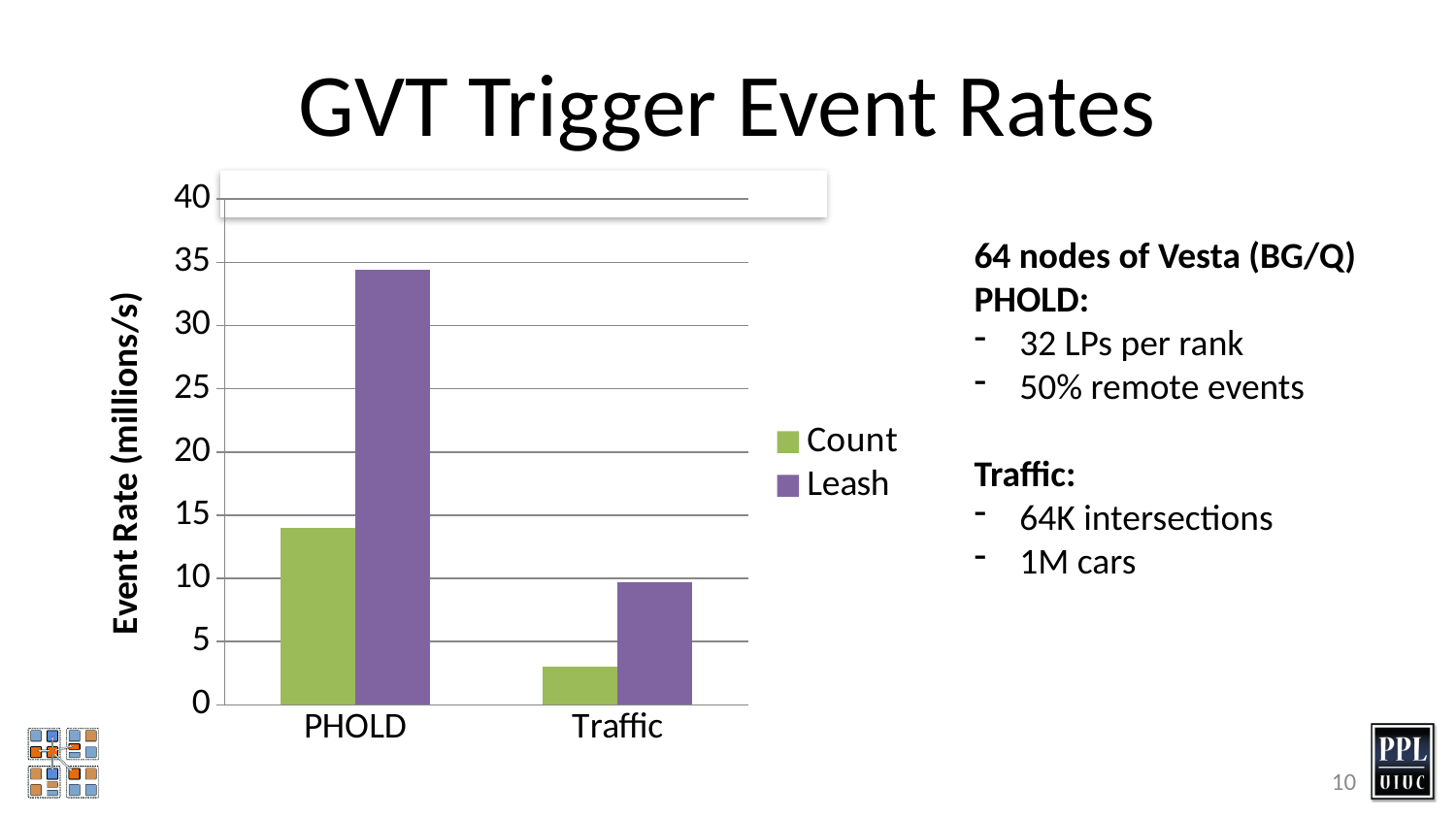
Which series and category has the highest event rate? Leash for PHOLD What is the label of the y axis? Event Rate (millions/s) How many categories are shown on the x axis? 2 Is the Leash value for Traffic greater or less than 5? greater Is the Count value for PHOLD greater or less than 15? less What kind of chart is shown on the slide? bar chart For Traffic, which series has the larger event rate, Count or Leash? Leash Is the Count value for Traffic greater or less than 5? less Which category has the higher Count value, PHOLD or Traffic? PHOLD Which series and category has the lowest event rate? Count for Traffic How many series does the legend list? 2